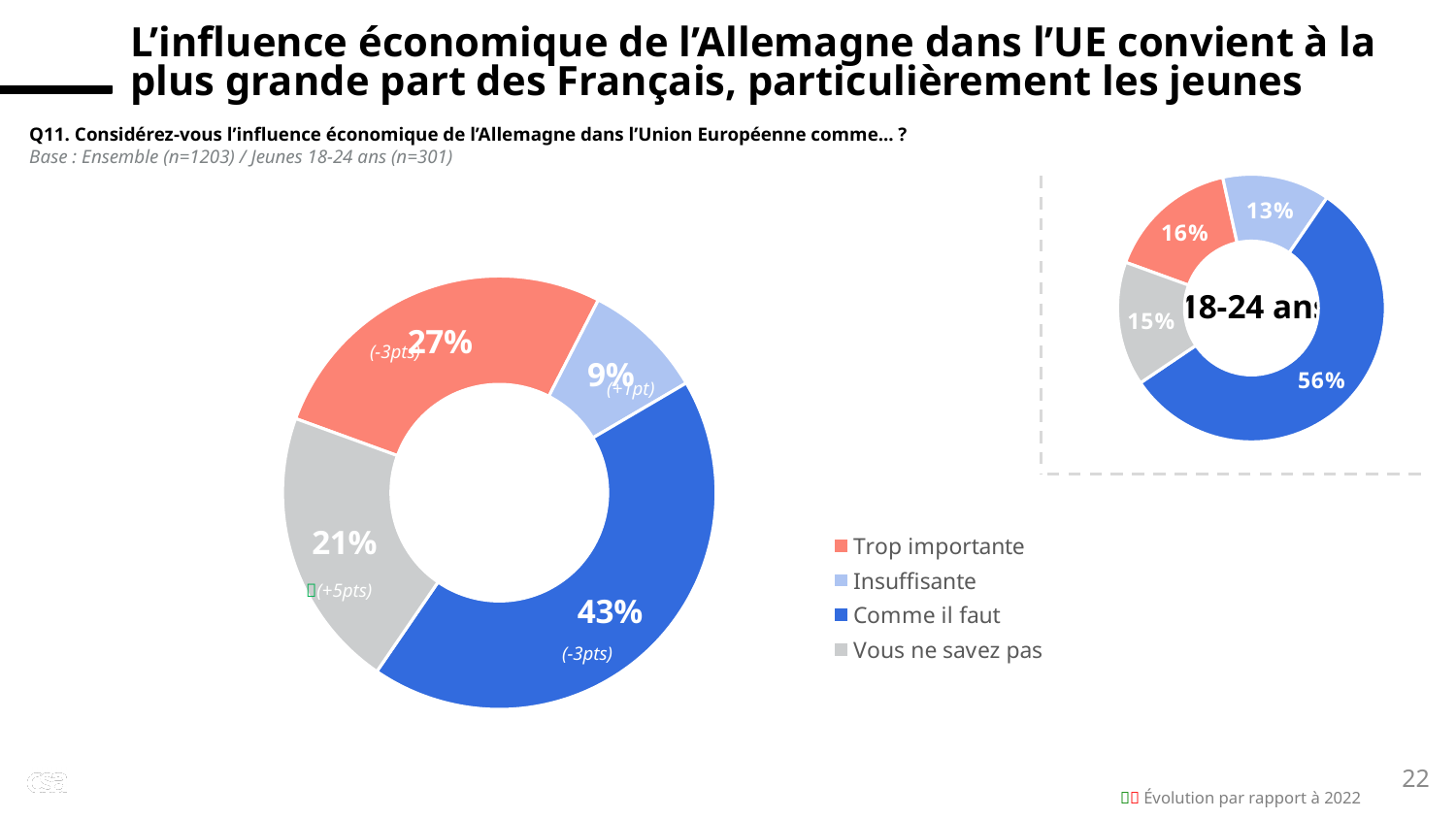
In the large donut chart on the left, what is the value for "Trop importante"? 27% In the large donut chart on the left, what is the value for "Vous ne savez pas"? 21% In the "18-24 ans" donut chart, what is the value for "Comme il faut"? 56% Which is larger: "Comme il faut" in the large donut chart on the left or "Comme il faut" in the "18-24 ans" donut chart? 18-24 ans In the large donut chart on the left, which category has the largest share? Comme il faut In the "18-24 ans" donut chart, what is the value for "Insuffisante"? 13% How many categories does the legend list? 4 In the large donut chart on the left, what is the value for "Comme il faut"? 43% In the "18-24 ans" donut chart, what is the value for "Trop importante"? 16% In the "18-24 ans" donut chart, what is the difference between "Comme il faut" and "Trop importante"? 40 points In the large donut chart on the left, which category has the smallest share? Insuffisante What kind of chart is used on this slide? Donut (pie) chart